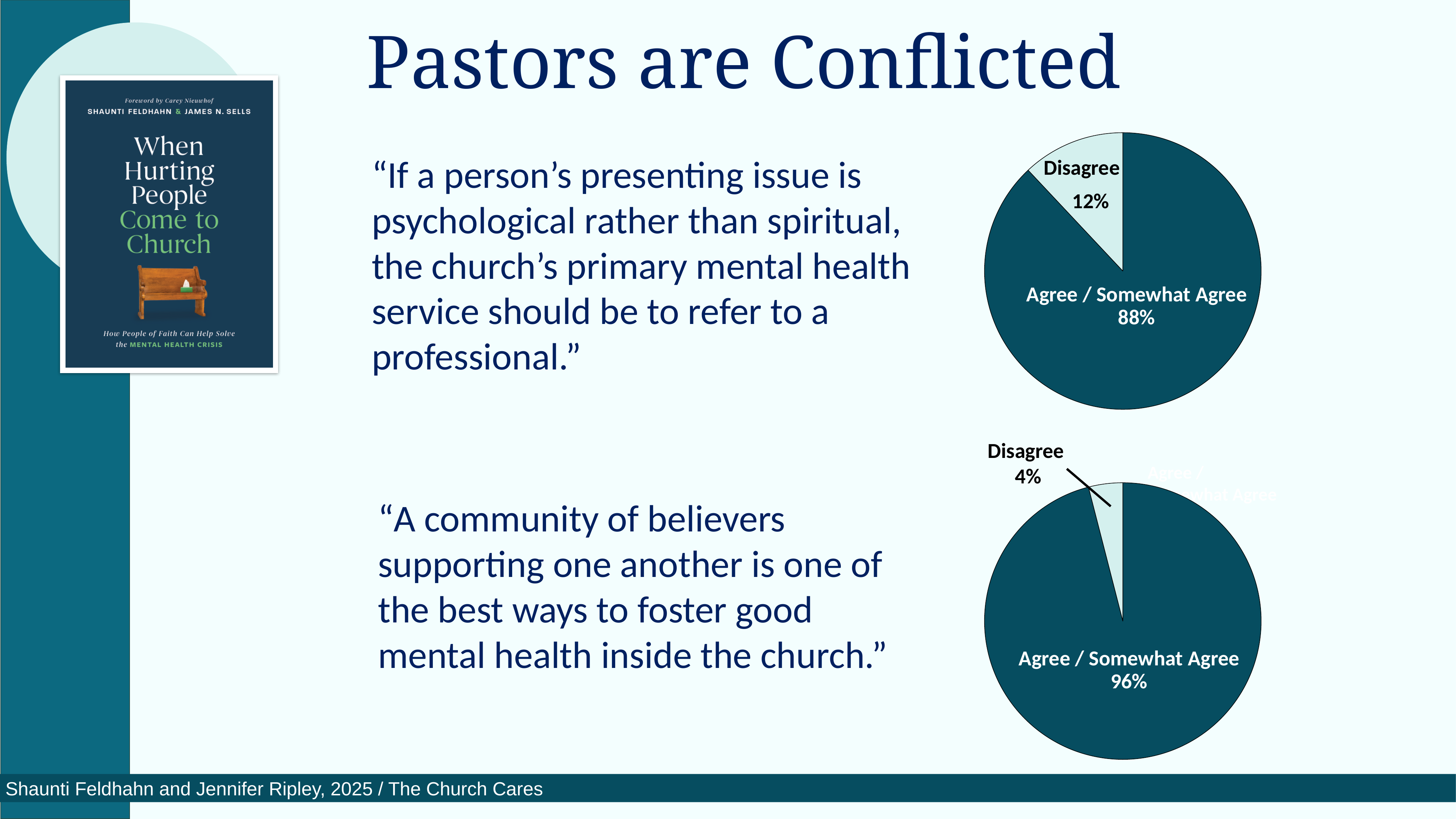
In the top pie chart, what percentage is labelled Disagree? 12% What type of chart is the bottom chart on the right of the slide? Pie chart In the top pie chart, which slice is the largest? Agree / Somewhat Agree How many pie charts are shown on the slide? 2 In the bottom pie chart, which slice is the smallest? Disagree How many slices does the top pie chart have? 2 In the bottom pie chart, what is the difference between the Agree / Somewhat Agree share and the Disagree share? 92% In the top pie chart, what is the difference between the Agree / Somewhat Agree share and the Disagree share? 76% In the bottom pie chart, what percentage is labelled Agree / Somewhat Agree? 96% Which chart has the larger Disagree share, the top pie chart or the bottom pie chart? The top pie chart In the top pie chart, what percentage is labelled Agree / Somewhat Agree? 88% In the bottom pie chart, what percentage is labelled Disagree? 4%